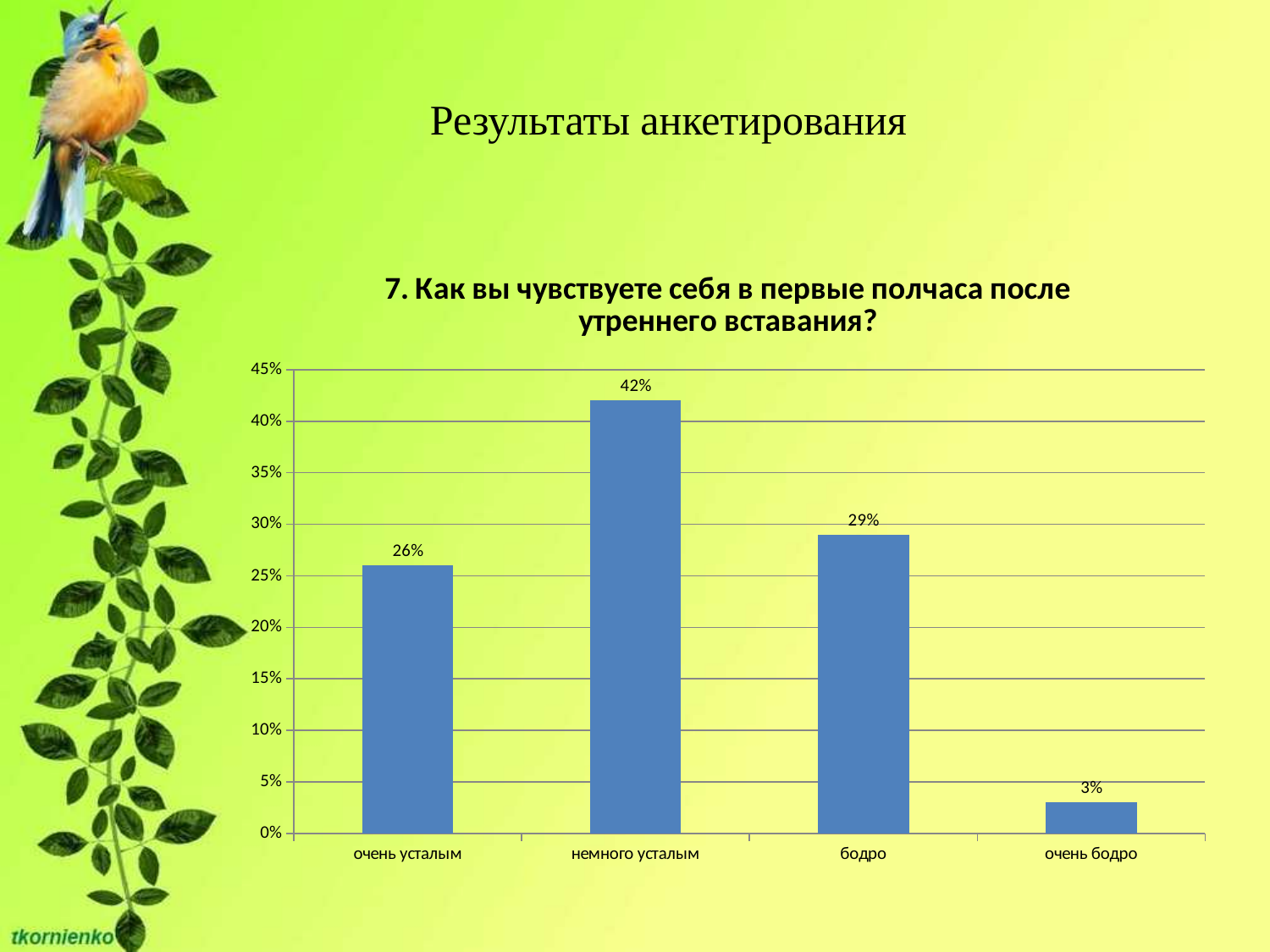
How many categories are shown on the x axis? 4 What kind of chart is shown on the slide? bar chart Which is larger, the value for "бодро" or the value for "очень усталым"? бодро Is the value for "бодро" greater or less than 25%? greater Which category has the lowest value? очень бодро What is the value shown for "очень усталым"? 26% What percentage of respondents answered "немного усталым"? 42% What is the title of the chart? 7. Как вы чувствуете себя в первые полчаса после утреннего вставания? Which category has the highest value? немного усталым What is the difference between the values for "немного усталым" and "бодро"? 13% What is the difference between the values for "очень усталым" and "очень бодро"? 23% What is the value shown for "очень бодро"? 3%